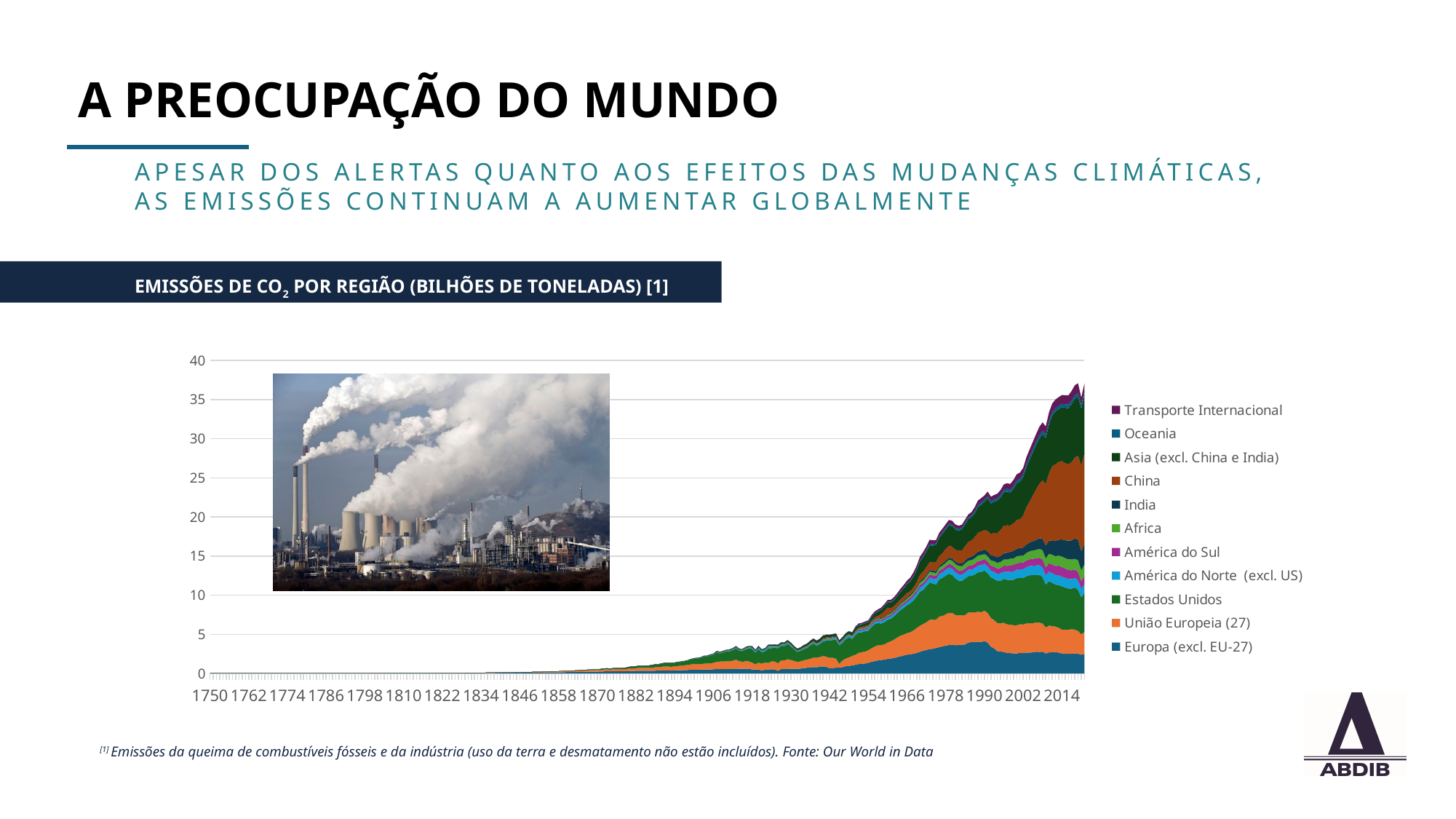
What is the highest value shown on the y axis? 40 What is the title of the chart? EMISSÕES DE CO2 POR REGIÃO (BILHÕES DE TONELADAS) [1] Do total CO2 emissions rise or fall along the x axis from 1750 to 2014? Rise What kind of chart is shown on the slide? Stacked area chart Is the total stacked value around 2014 greater or less than 30? greater What is the first year label on the x axis? 1750 Is the total stacked value around 1990 greater or less than 20? greater How many series does the chart's legend list? 11 Is the total stacked value around 1850 greater or less than 5? less What is the last year label on the x axis? 2014